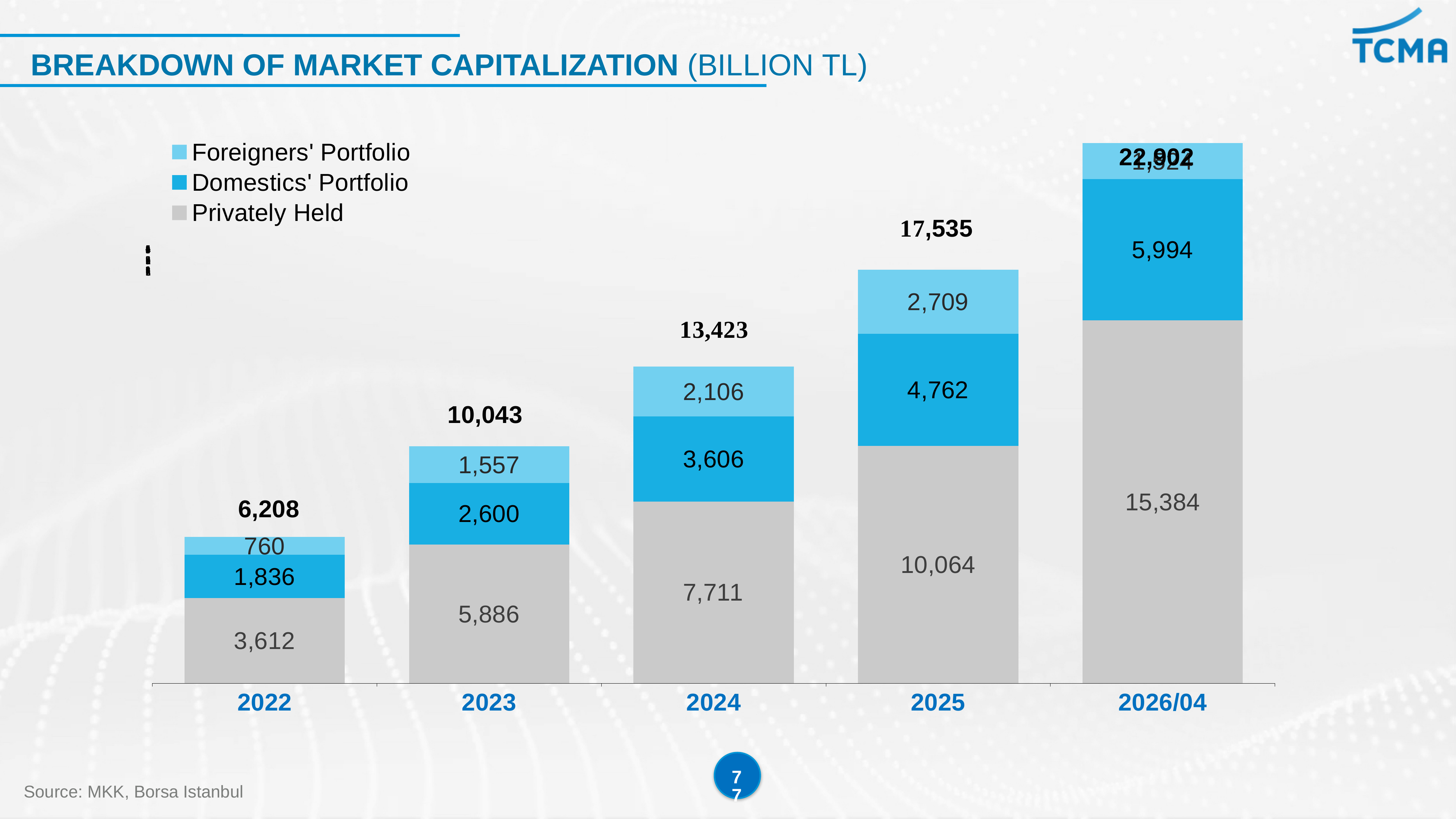
What is the Privately Held value for 2026/04? 15,384 Which year has the lowest Privately Held value? 2022 What is the Domestics' Portfolio value for 2025? 4,762 What is the total market capitalization shown for 2023? 10,043 What is the Foreigners' Portfolio value for 2024? 2,106 How many series does the legend list? 3 Which period has the highest Domestics' Portfolio value? 2026/04 What kind of chart is shown on the slide? Stacked bar chart What is the Privately Held value for 2022? 3,612 Which is larger, the Foreigners' Portfolio value for 2023 or the Domestics' Portfolio value for 2023? Domestics' Portfolio How many periods are shown on the x axis? 5 What is the difference between the Privately Held values for 2025 and 2024? 2,353